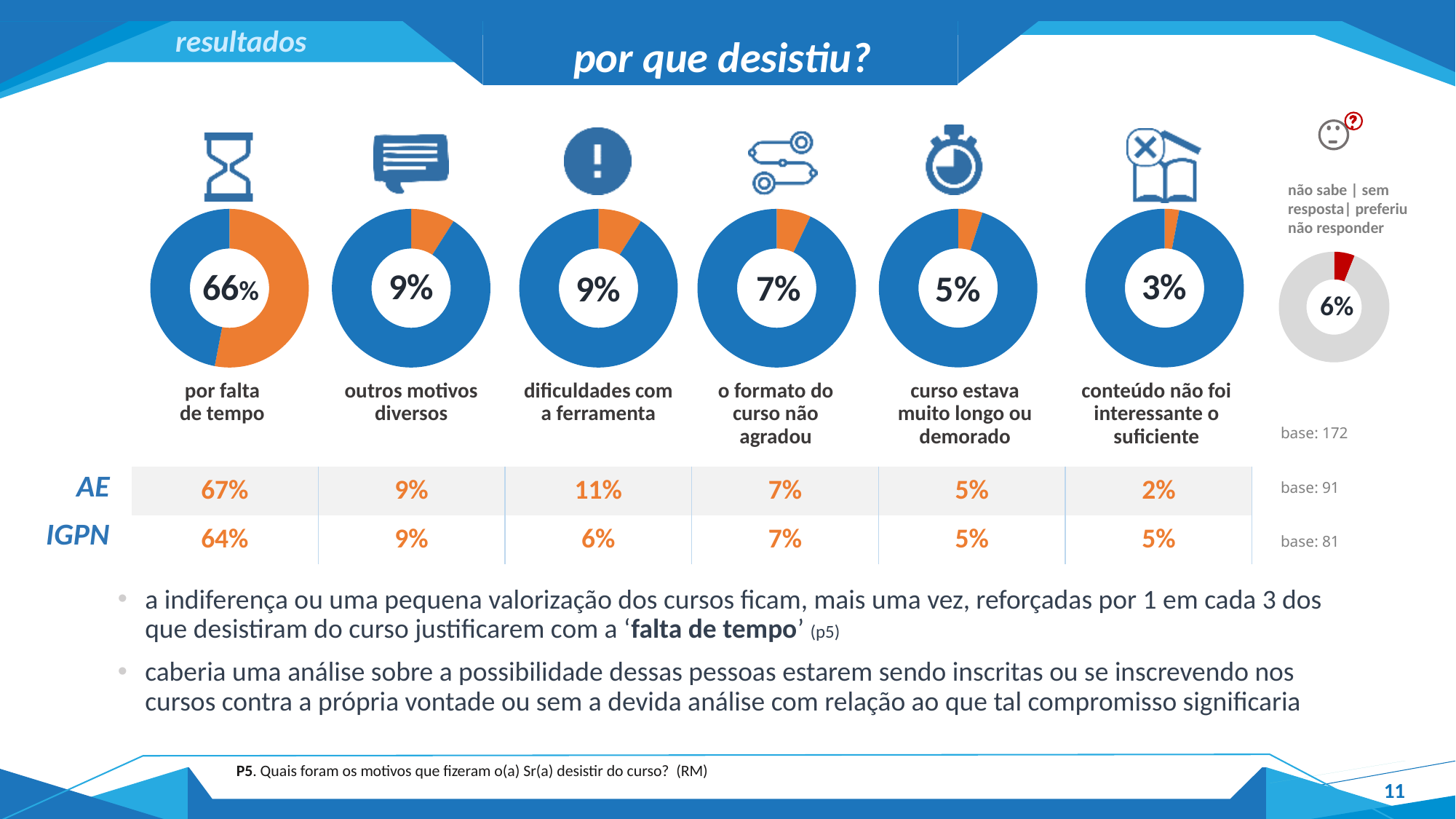
Among the six blue-and-orange donut charts, which reason has the lowest percentage? conteúdo não foi interessante o suficiente What percentage is shown in the grey donut chart labelled 'não sabe | sem resposta | preferiu não responder'? 6% What is the difference between the percentage in the 'por falta de tempo' donut chart and the percentage in the 'outros motivos diversos' donut chart? 57% What percentage is shown in the donut chart labelled 'por falta de tempo'? 66% What percentage is shown in the donut chart labelled 'o formato do curso não agradou'? 7% How many donut charts are shown on the slide? 7 What percentage is shown in the donut chart labelled 'curso estava muito longo ou demorado'? 5% Among the donut charts on the slide, which reason has the highest percentage? por falta de tempo Which is larger: the percentage in the 'o formato do curso não agradou' donut chart or the percentage in the 'curso estava muito longo ou demorado' donut chart? o formato do curso não agradou What colour is the highlighted slice in the 'não sabe | sem resposta | preferiu não responder' donut chart? Red What percentage is shown in the donut chart labelled 'conteúdo não foi interessante o suficiente'? 3% What type of chart is used to show the percentage for 'dificuldades com a ferramenta'? Donut chart